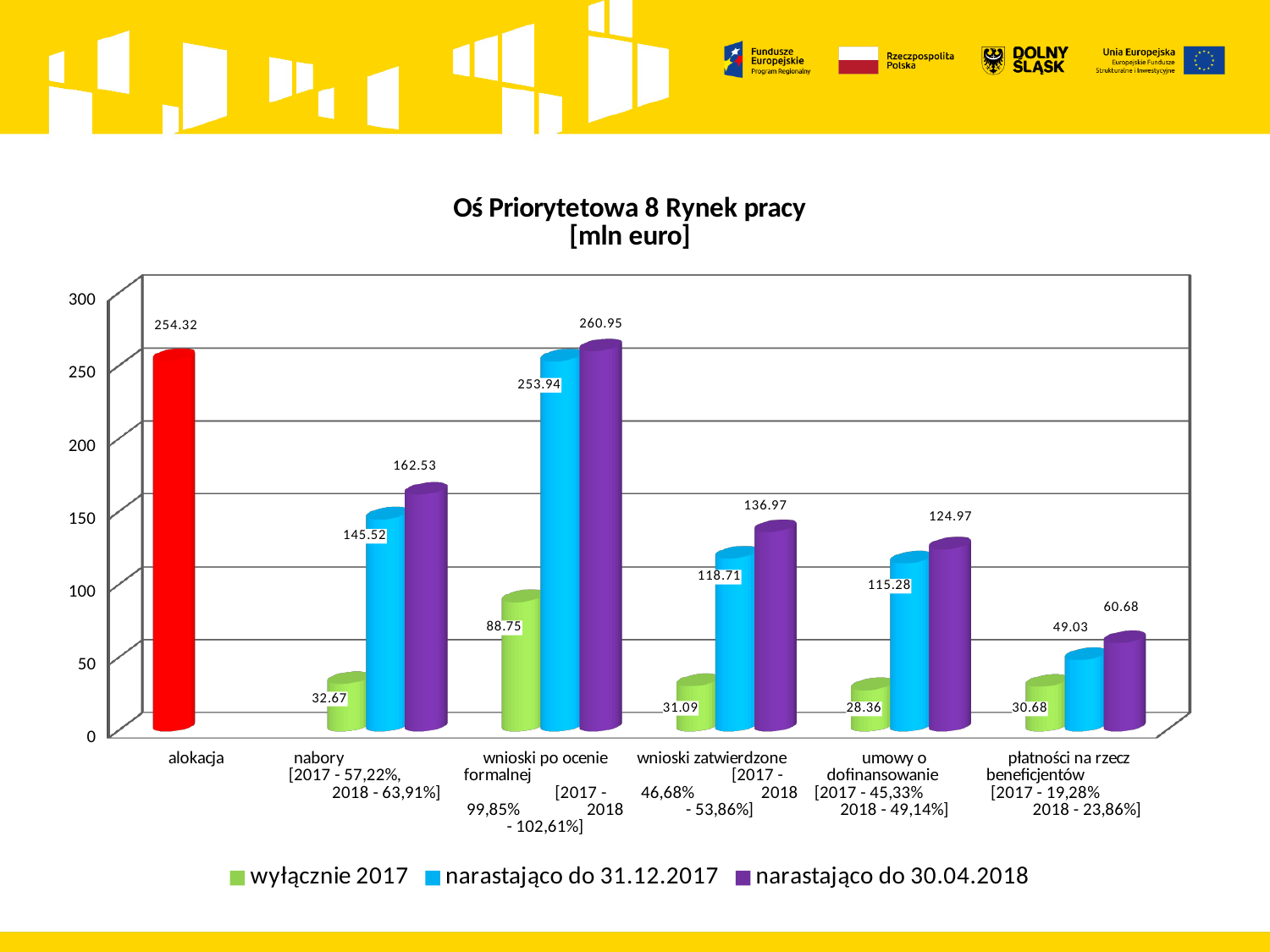
What unit is given in the chart title? mln euro How many series does the legend list? 3 What is the value shown for 'alokacja'? 254.32 What is the value of 'wyłącznie 2017' for 'nabory'? 32.67 Which category has the lowest 'narastająco do 30.04.2018' value? płatności na rzecz beneficjentów What is the value of 'narastająco do 30.04.2018' for 'wnioski po ocenie formalnej'? 260.95 Is the 'narastająco do 30.04.2018' value for 'płatności na rzecz beneficjentów' greater or less than 100? less Which is larger: 'narastająco do 31.12.2017' for 'nabory' or 'narastająco do 31.12.2017' for 'umowy o dofinansowanie'? nabory What is the value of 'narastająco do 31.12.2017' for 'umowy o dofinansowanie'? 115.28 What type of chart is shown on the slide? bar chart What is the difference between 'narastająco do 30.04.2018' and 'narastająco do 31.12.2017' for 'wnioski zatwierdzone'? 18.26